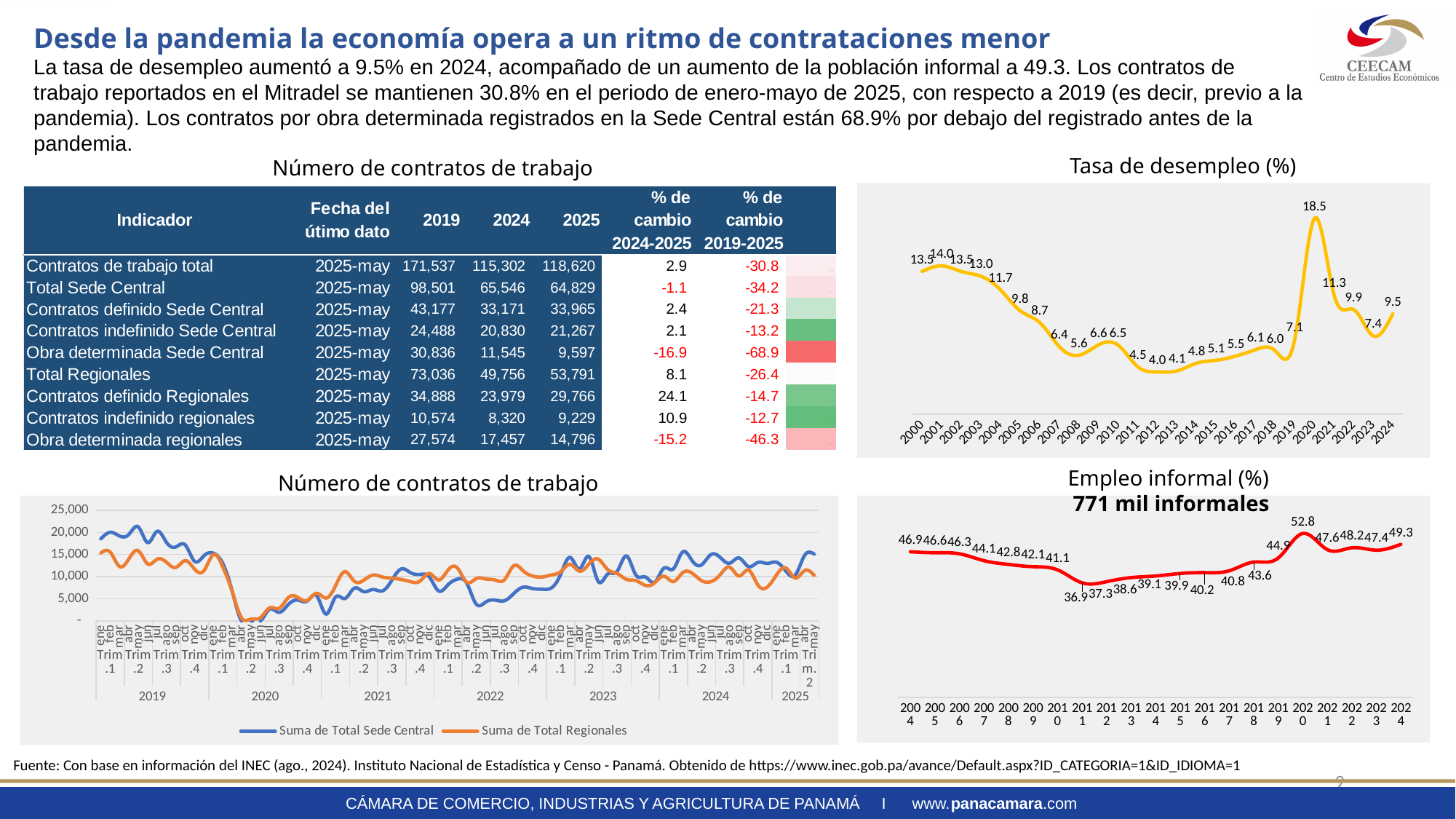
In the 'Empleo informal (%)' chart, what is the difference between the 2024 and 2023 values? 1.9 In the 'Tasa de desempleo (%)' chart, what is the difference between the 2020 and 2021 unemployment rates? 7.2 In the 'Tasa de desempleo (%)' chart, which year has the lowest unemployment rate? 2012 In the 'Empleo informal (%)' chart, what is the value for 2020? 52.8 In the 'Número de contratos de trabajo' line chart, is the value of 'Suma de Total Sede Central' in May 2020 greater or less than 5,000? less In the 'Empleo informal (%)' chart, how many years are plotted? 21 In the 'Tasa de desempleo (%)' chart, is the unemployment rate higher in 2023 or in 2024? 2024 In the 'Empleo informal (%)' chart, which year has the lowest value? 2011 In the 'Tasa de desempleo (%)' chart, what is the unemployment rate for 2024? 9.5 In the 'Tasa de desempleo (%)' chart, what is the unemployment rate for 2020? 18.5 In the 'Número de contratos de trabajo' line chart, how many series does the legend list? 2 In the 'Tasa de desempleo (%)' chart, which year has the highest unemployment rate? 2020